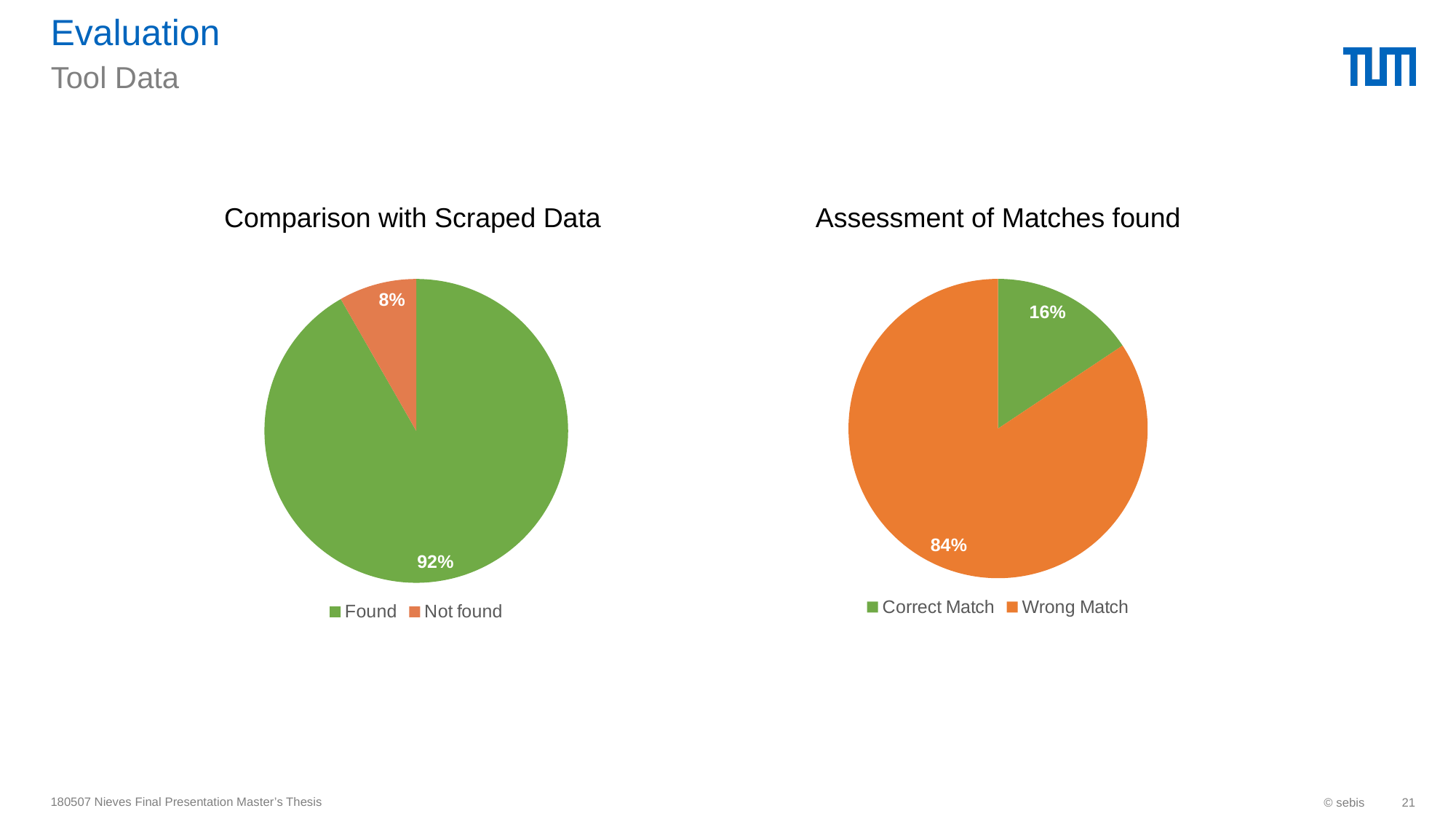
In the 'Assessment of Matches found' chart, which is larger: 'Correct Match' or 'Wrong Match'? Wrong Match In the 'Assessment of Matches found' chart, what share of the pie is 'Correct Match'? 16% What kind of chart is the 'Comparison with Scraped Data' chart? Pie chart In the 'Comparison with Scraped Data' chart, what share of the pie is 'Found'? 92% In the 'Assessment of Matches found' chart, which slice is the smallest? Correct Match In the 'Comparison with Scraped Data' chart, which slice is the largest? Found How many slices does the 'Assessment of Matches found' chart have? 2 In the 'Assessment of Matches found' chart, what share of the pie is 'Wrong Match'? 84% In the 'Assessment of Matches found' chart, what is the difference between the 'Wrong Match' and 'Correct Match' shares? 68% In the 'Comparison with Scraped Data' chart, what is the difference between the 'Found' and 'Not found' shares? 84% In the 'Comparison with Scraped Data' chart, what colour is the 'Not found' slice? Orange